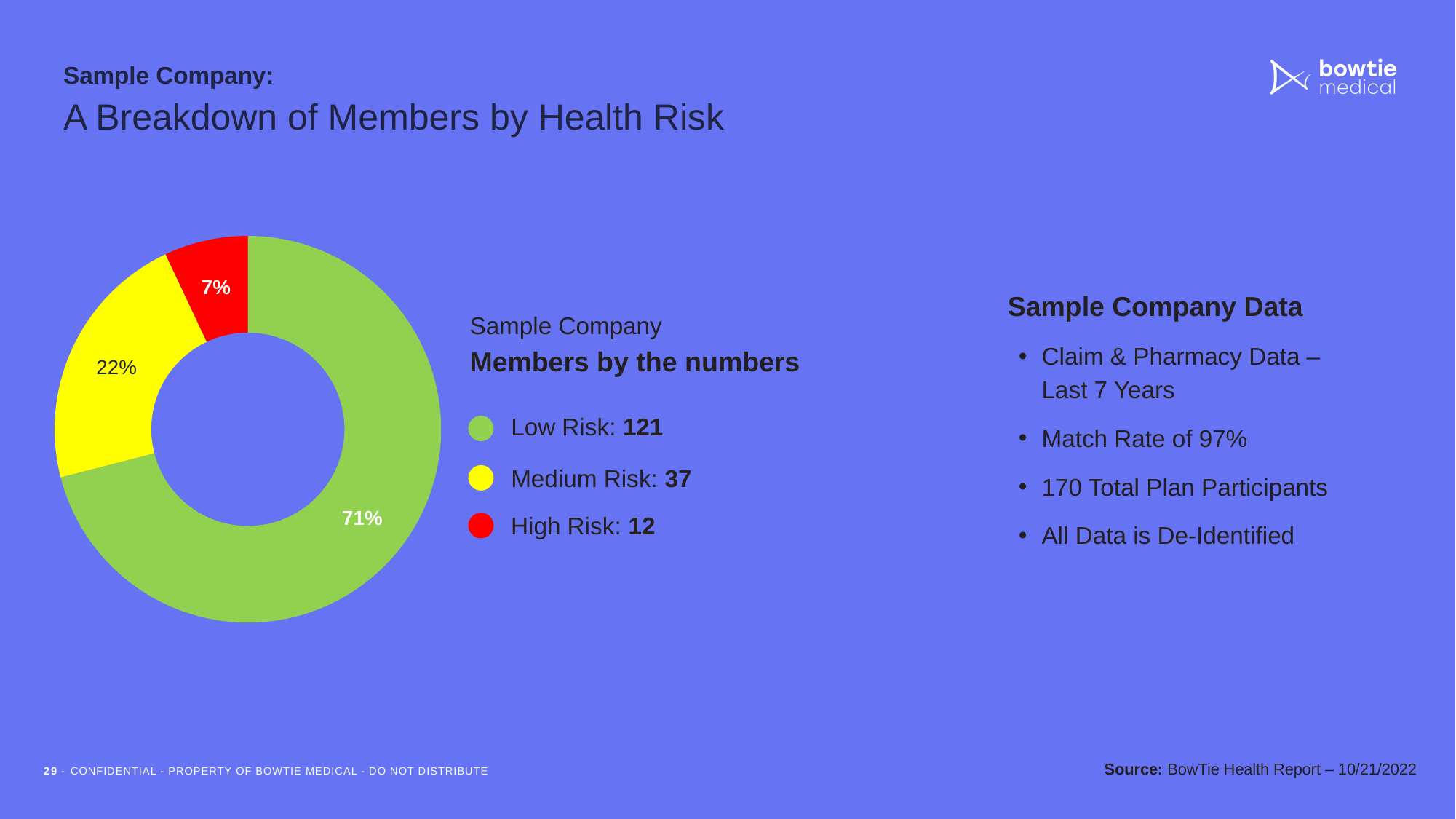
Which risk category has the largest share of members? Low Risk How many risk categories does the chart show? 3 How many members are in the Medium Risk category? 37 What kind of chart is shown on the slide? Pie chart (donut) What percentage of members are Low Risk according to the chart? 71% How many members are in the High Risk category? 12 Which risk category has the smallest share of members? High Risk What percentage of members are Medium Risk according to the chart? 22% How many more members are Medium Risk than High Risk? 25 What percentage of members are High Risk according to the chart? 7% How many members are in the Low Risk category? 121 Which colour represents the Medium Risk category in the chart? Yellow